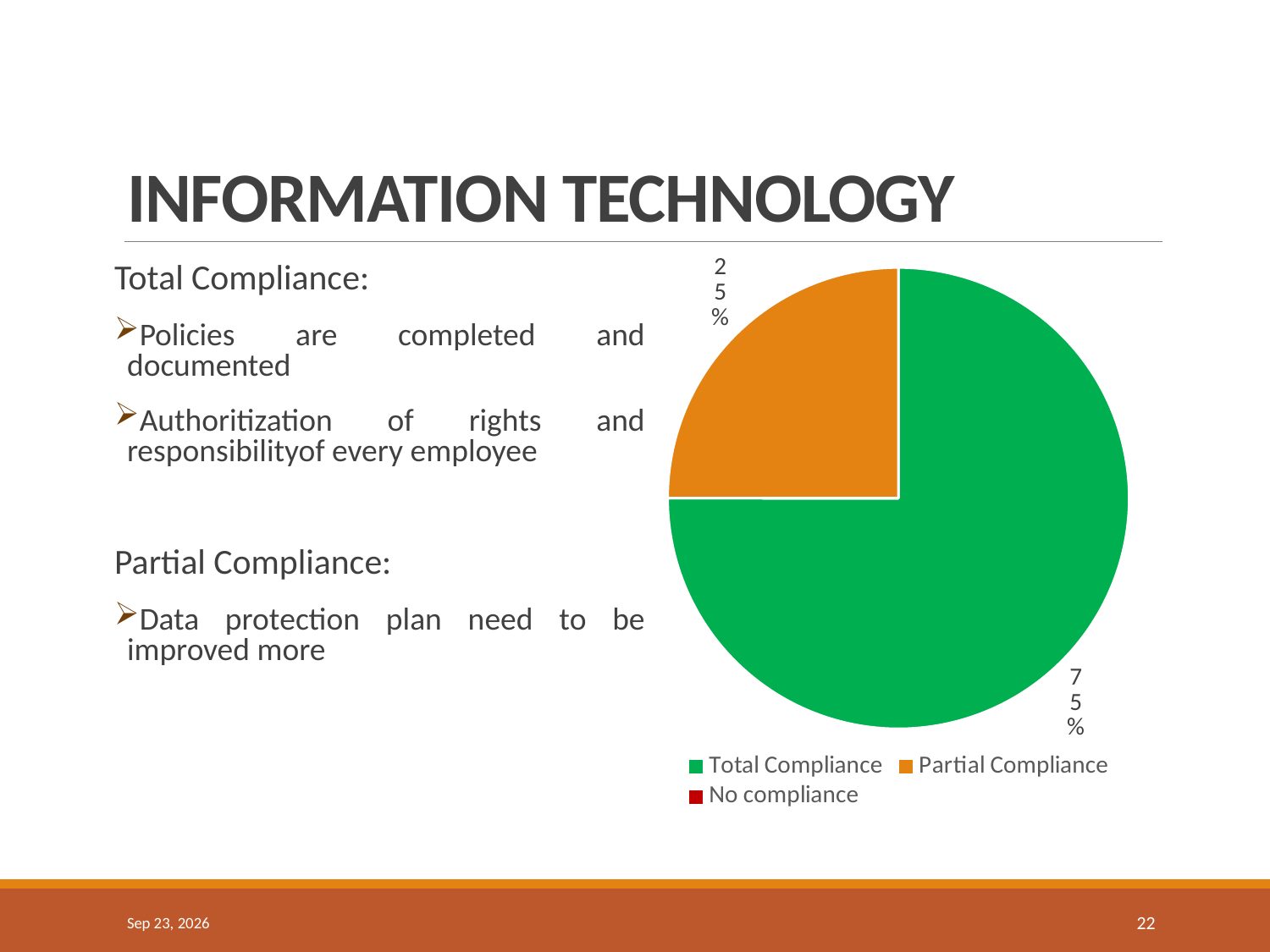
What share of the pie does Partial Compliance represent? 25% What is the difference in percentage points between the Total Compliance and Partial Compliance slices? 50 Which of the visible slices is the smallest? Partial Compliance What kind of chart is shown on the slide? pie chart What colour is the Total Compliance slice? green Which category has the largest slice of the pie? Total Compliance How many entries does the legend list? 3 Which is larger, the Total Compliance slice or the Partial Compliance slice? Total Compliance What share of the pie does Total Compliance represent? 75% What colour is the Partial Compliance slice? orange How many slices are visible in the pie chart? 2